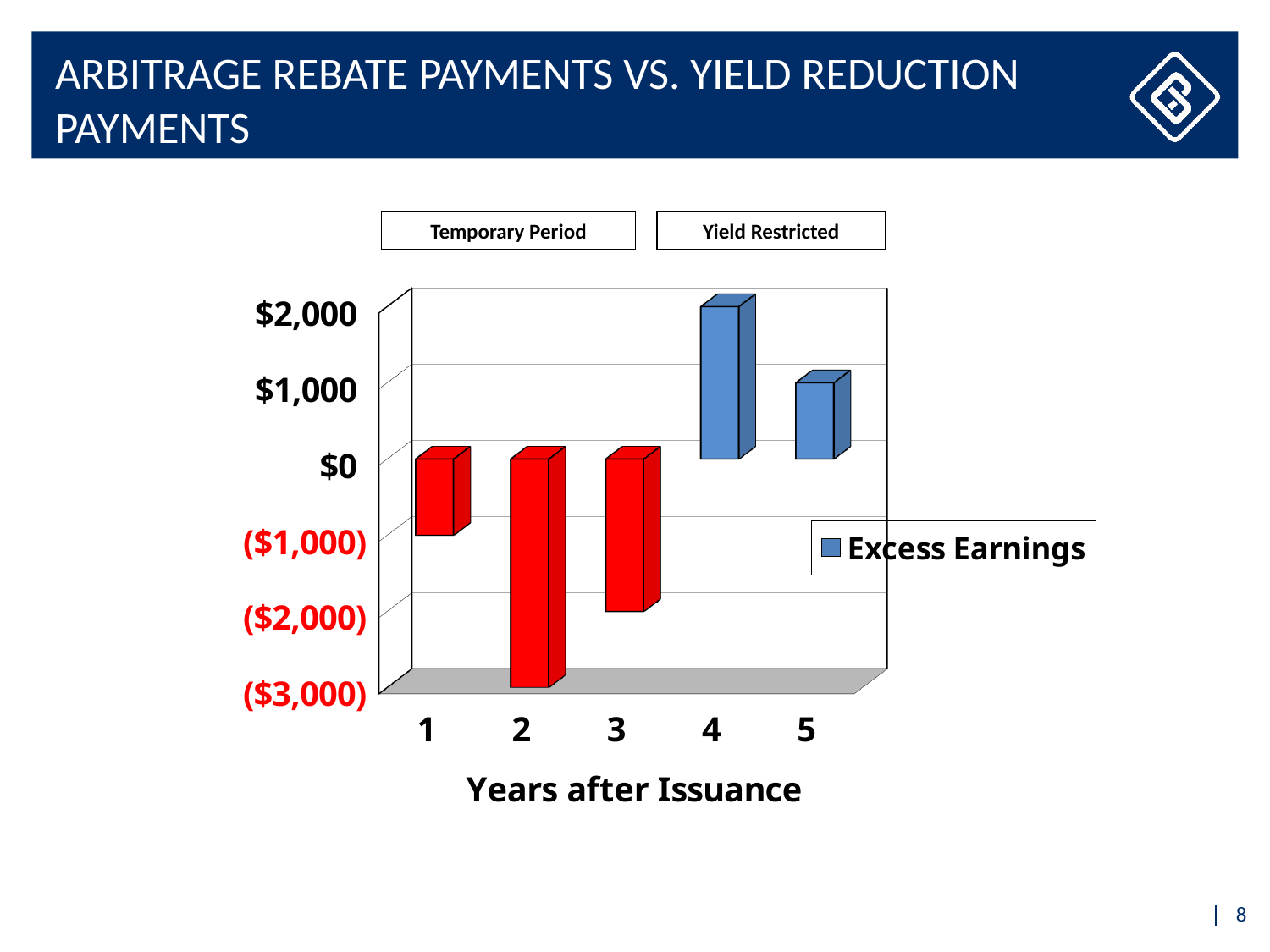
What is the name of the series shown in the legend? Excess Earnings Is the value for year 4 greater or less than $1,000? greater Which year after issuance has the lowest excess earnings? 2 What is the title of the x axis? Years after Issuance Which year after issuance has the highest excess earnings? 4 How many series does the legend list? 1 Is the value for year 1 greater or less than ($2,000)? greater Do the values rise or fall from year 4 to year 5? fall Which is larger, the value for year 4 or the value for year 5? year 4 What kind of chart is shown on the slide? bar chart How many years are plotted along the x axis? 5 Is the value for year 2 greater or less than ($2,000)? less